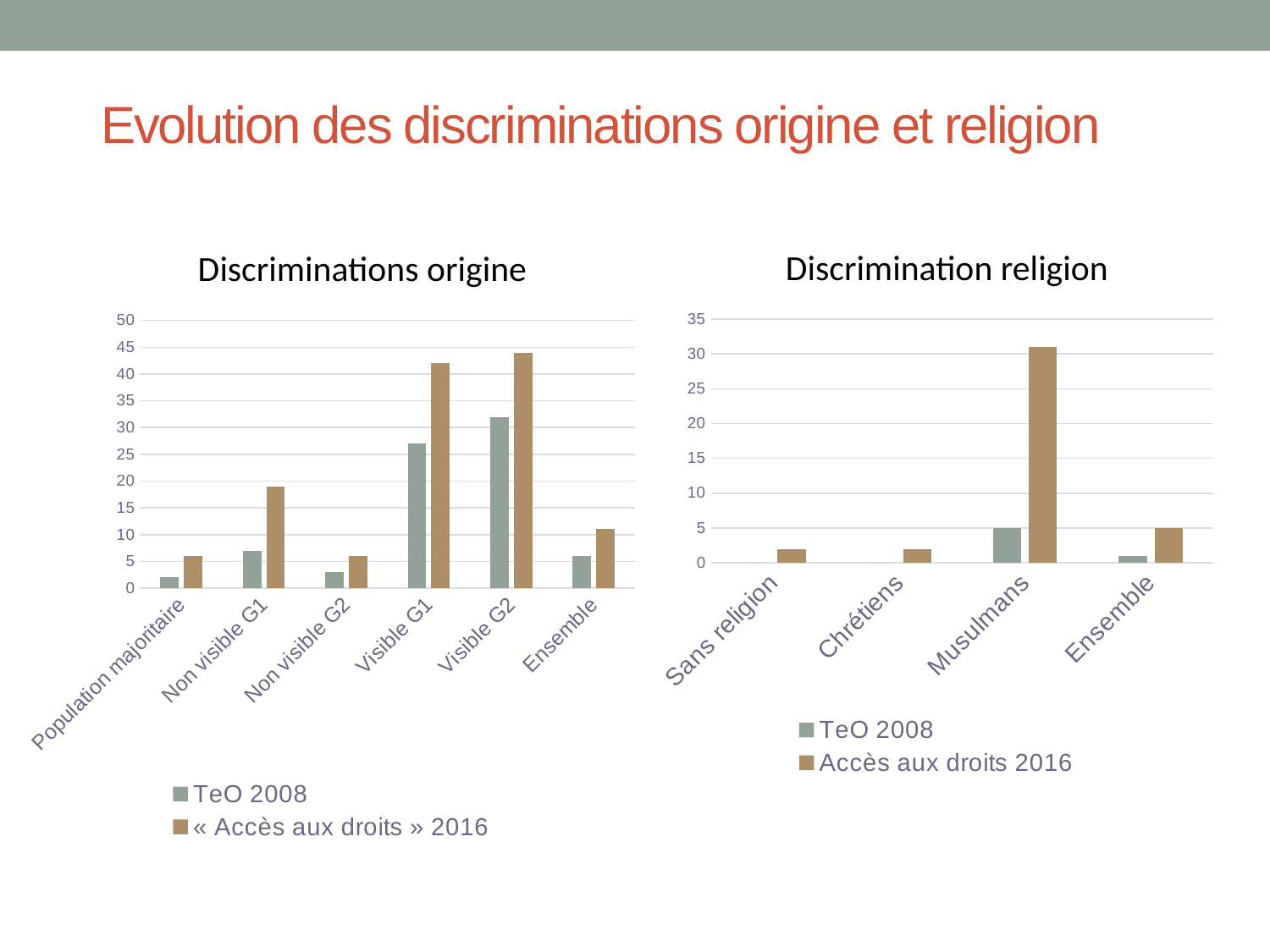
In the "Discrimination religion" chart, which category has the highest value for Accès aux droits 2016? Musulmans How many series does the legend of the "Discriminations origine" chart list? 2 In the "Discriminations origine" chart, which category has the highest value for « Accès aux droits » 2016? Visible G2 What are the two legend entries of the "Discrimination religion" chart? TeO 2008 and Accès aux droits 2016 What kind of chart is the "Discriminations origine" chart on the left? bar chart How many categories are shown on the x axis of the "Discrimination religion" chart? 4 How many categories are shown on the x axis of the "Discriminations origine" chart? 6 In the "Discrimination religion" chart, is the Accès aux droits 2016 value for Musulmans greater or less than 30? greater In the "Discrimination religion" chart, is the Accès aux droits 2016 value for Sans religion greater or less than 5? less In the "Discriminations origine" chart, is the « Accès aux droits » 2016 value for Visible G1 greater or less than 40? greater In the "Discriminations origine" chart, for Non visible G1, which series has the larger value: TeO 2008 or « Accès aux droits » 2016? « Accès aux droits » 2016